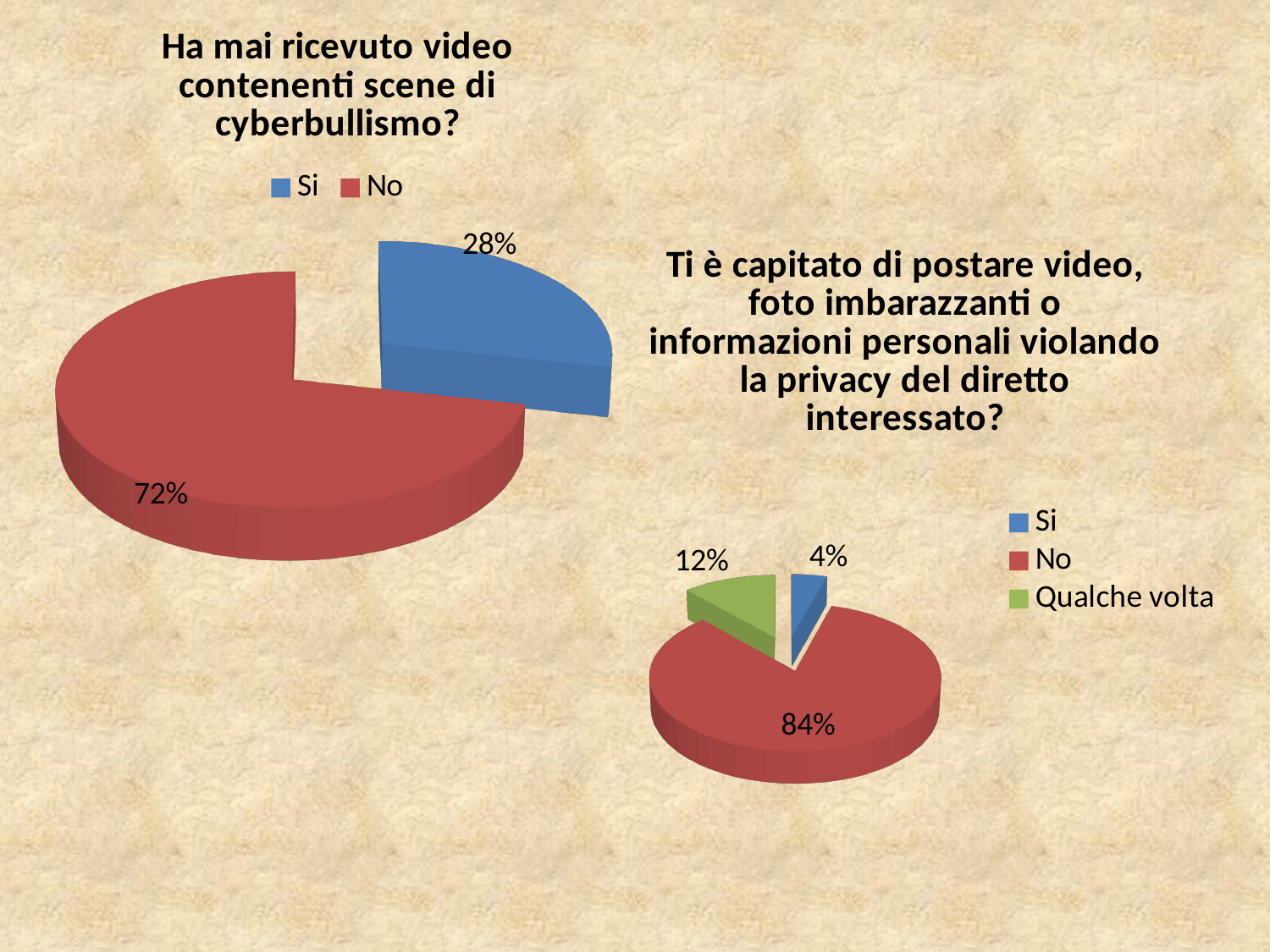
In the chart titled "Ha mai ricevuto video contenenti scene di cyberbullismo?", what is the difference in percentage points between "No" and "Si"? 44 In the chart titled "Ti è capitato di postare video, foto imbarazzanti o informazioni personali violando la privacy del diretto interessato?", what percentage is shown for "No"? 84% In the chart titled "Ti è capitato di postare video, foto imbarazzanti o informazioni personali violando la privacy del diretto interessato?", what percentage is shown for "Si"? 4% What kind of chart is the one titled "Ha mai ricevuto video contenenti scene di cyberbullismo?"? Pie chart In the chart titled "Ti è capitato di postare video, foto imbarazzanti o informazioni personali violando la privacy del diretto interessato?", which category has the smallest share? Si In the chart titled "Ti è capitato di postare video, foto imbarazzanti o informazioni personali violando la privacy del diretto interessato?", which is larger, "Qualche volta" or "Si"? Qualche volta In the chart titled "Ha mai ricevuto video contenenti scene di cyberbullismo?", what percentage is shown for "Si"? 28% In the chart titled "Ti è capitato di postare video, foto imbarazzanti o informazioni personali violando la privacy del diretto interessato?", how many categories does the legend list? 3 In the chart titled "Ti è capitato di postare video, foto imbarazzanti o informazioni personali violando la privacy del diretto interessato?", what percentage is shown for "Qualche volta"? 12% In the chart titled "Ha mai ricevuto video contenenti scene di cyberbullismo?", what colour is the "Si" slice? Blue In the chart titled "Ha mai ricevuto video contenenti scene di cyberbullismo?", which category has the largest share? No In the chart titled "Ha mai ricevuto video contenenti scene di cyberbullismo?", what percentage is shown for "No"? 72%